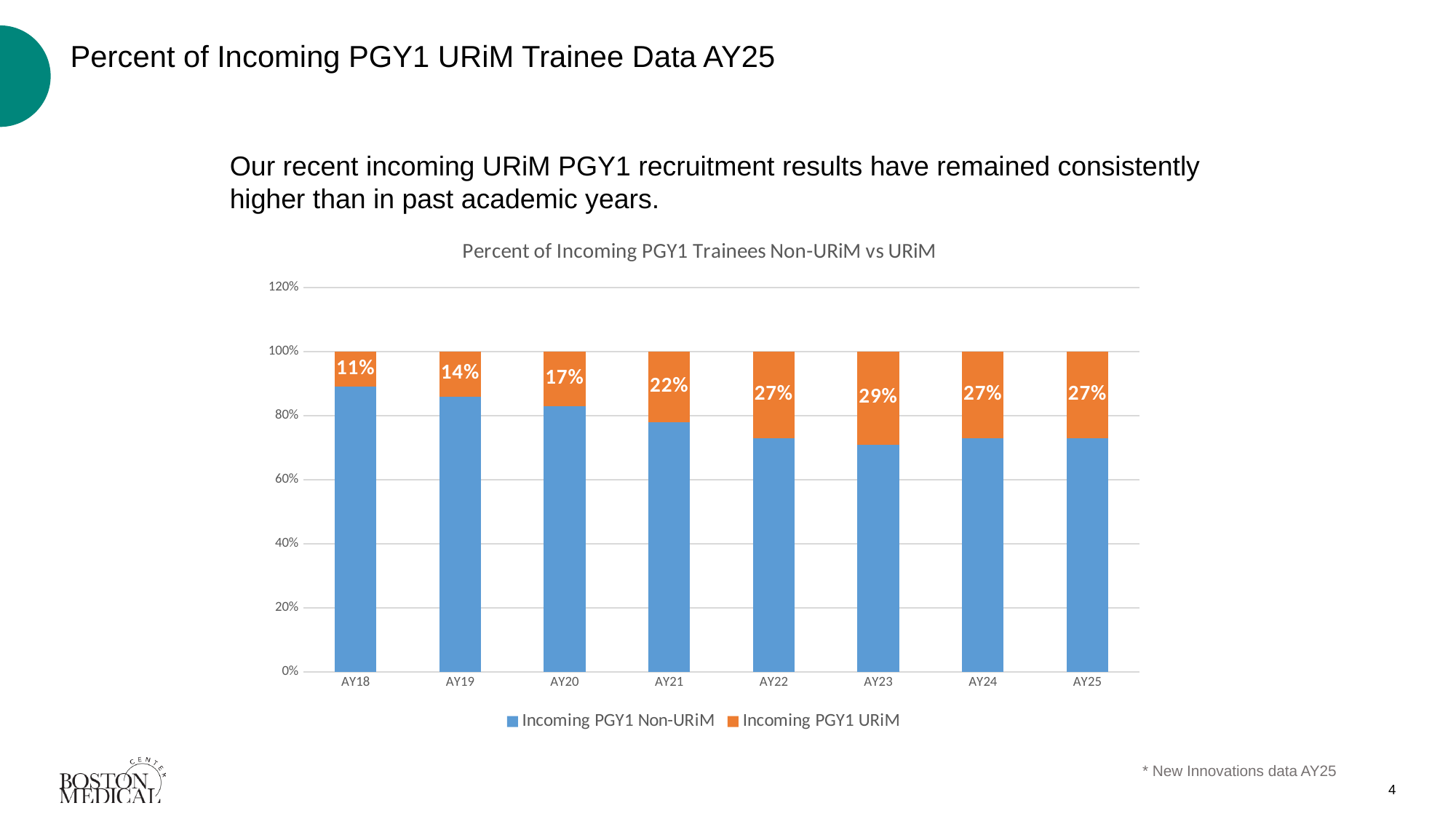
What is the difference between the Incoming PGY1 URiM percentage in AY23 and in AY18? 18% Which year has a larger Incoming PGY1 URiM percentage, AY20 or AY21? AY21 Is the Incoming PGY1 Non-URiM value for AY18 greater or less than 80%? greater What is the Incoming PGY1 URiM percentage for AY18? 11% Which academic year has the lowest Incoming PGY1 URiM percentage? AY18 How many academic years are shown on the x axis of the chart? 8 Is the Incoming PGY1 Non-URiM value for AY23 greater or less than 80%? less What is the Incoming PGY1 URiM percentage for AY21? 22% What type of chart is shown on the slide? Stacked bar chart Which academic year has the highest Incoming PGY1 URiM percentage? AY23 How many series does the chart legend list? 2 What is the Incoming PGY1 URiM percentage for AY25? 27%